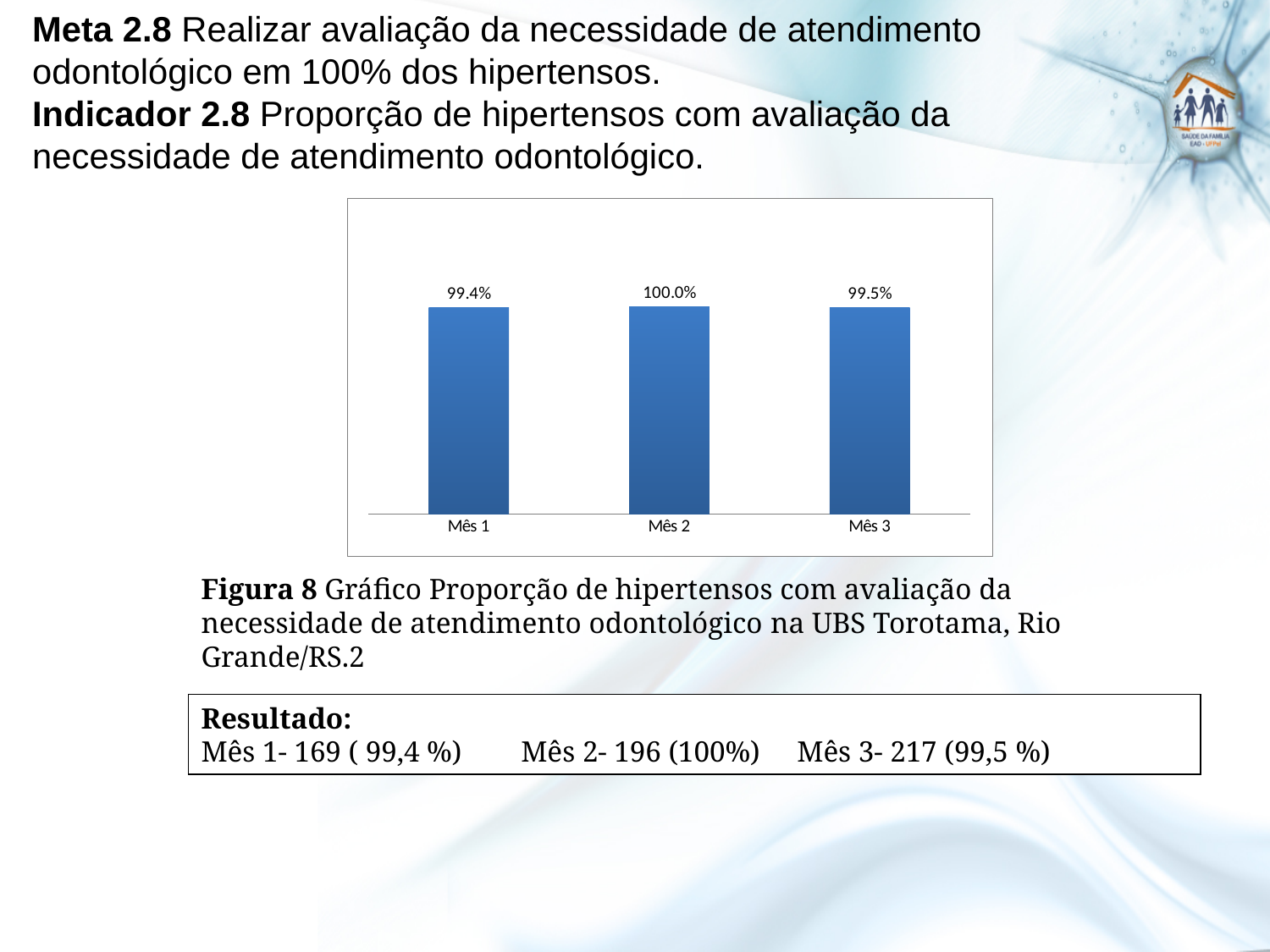
Does the value rise or fall from Mês 1 to Mês 2? Rises Which month has the lowest value in the chart? Mês 1 What is the difference between the values for Mês 2 and Mês 1? 0.6 percentage points How many months (categories) are plotted in the chart? 3 What kind of chart is shown on the slide? Bar chart What is the value shown for Mês 2? 100.0% What is the value shown for Mês 3? 99.5% What is the difference between the values for Mês 3 and Mês 1? 0.1 percentage points Which is larger, the value for Mês 2 or the value for Mês 3? Mês 2 What colour are the bars in the chart? Blue Which month has the highest value in the chart? Mês 2 What is the value shown for Mês 1? 99.4%